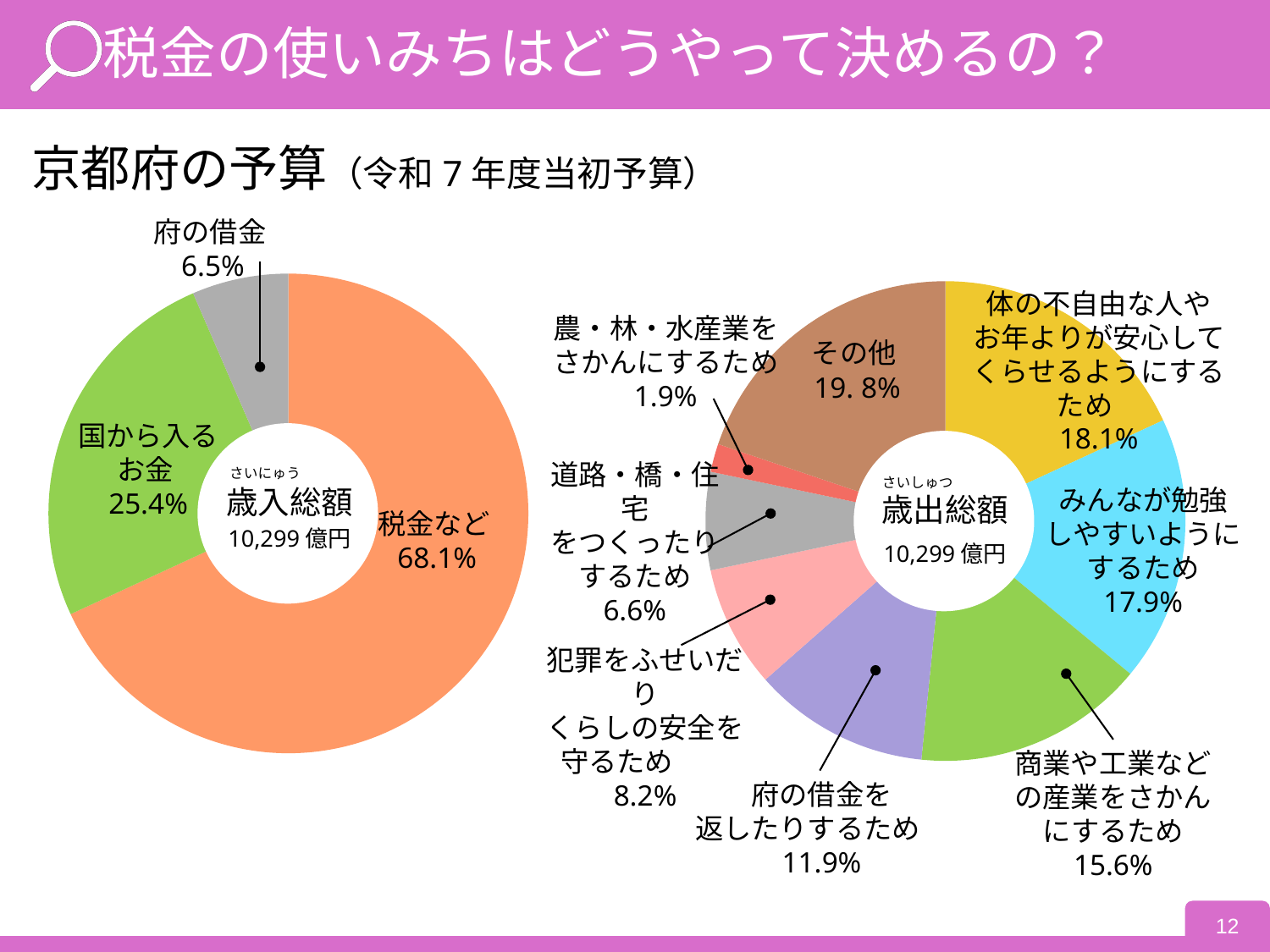
In the right chart (歳出総額), which is larger: 犯罪をふせいだりくらしの安全を守るため or 道路・橋・住宅をつくったりするため? 犯罪をふせいだりくらしの安全を守るため In the right chart (歳出総額), how many slices are there? 8 In the left chart (歳入総額), what is the share for 税金など? 68.1% In the left chart (歳入総額), how many slices are there? 3 In the right chart (歳出総額), what is the share for 府の借金を返したりするため? 11.9% In the left chart (歳入総額), what is the share for 国から入るお金? 25.4% In the left chart (歳入総額), which category has the smallest share? 府の借金 What total amount is shown in the centre of the right chart (歳出総額)? 10,299 億円 In the left chart (歳入総額), what is the difference between the shares of 税金など and 国から入るお金? 42.7% In the right chart (歳出総額), what is the share for 農・林・水産業をさかんにするため? 1.9% In the right chart (歳出総額), which category has the largest share? その他 What kind of chart is the right chart (歳出総額)? Pie (donut) chart